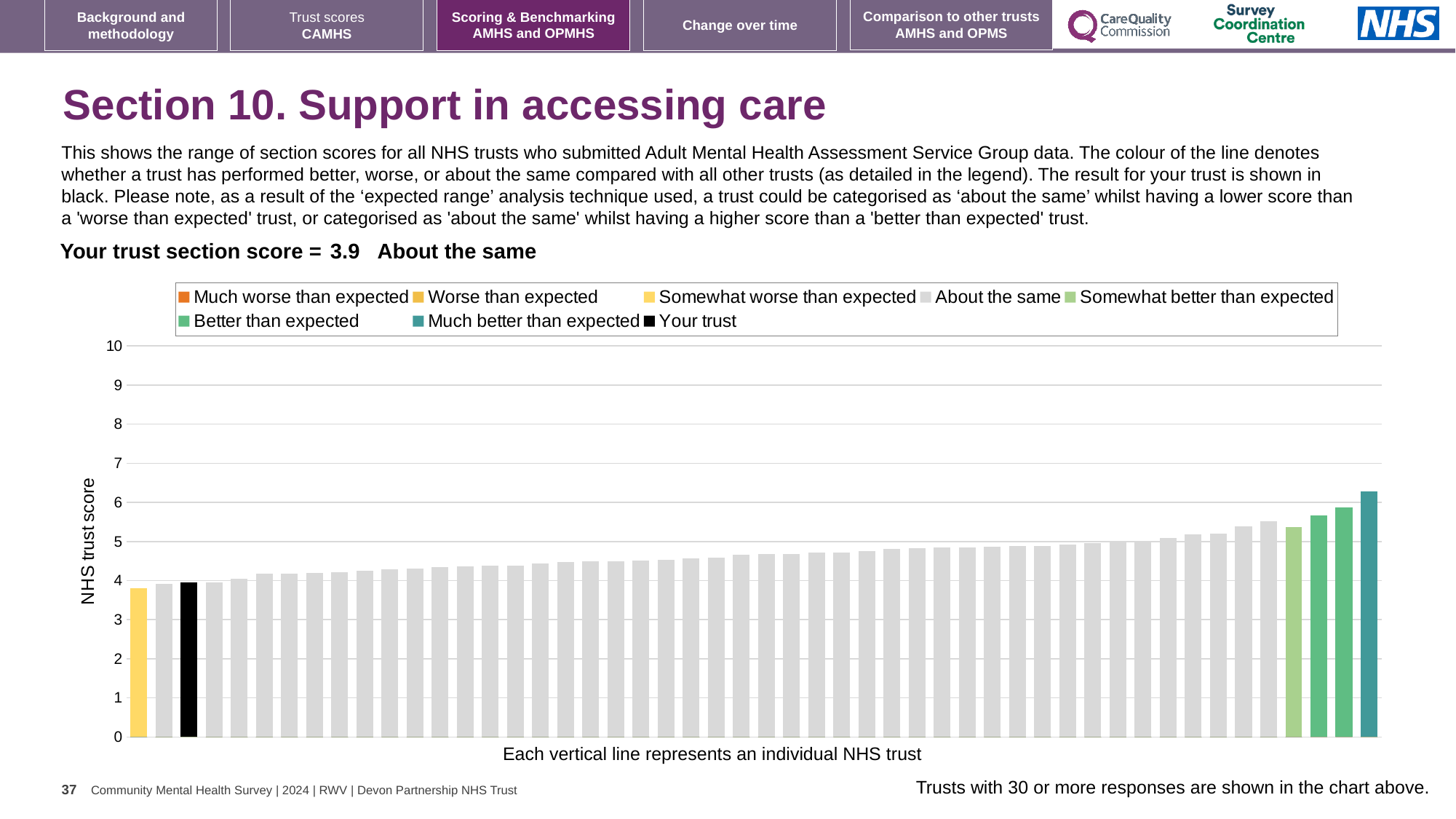
What is the section score for your trust? 3.9 How is your trust categorised compared with other trusts? About the same Do the bar values rise or fall from left to right along the x axis? rise Which legend category does the highest-scoring trust belong to? Much better than expected How many entries does the chart legend list? 8 Is the highest bar in the chart greater or less than 7? less What kind of chart is shown on the slide? bar chart Which legend category does the lowest-scoring trust belong to? Somewhat worse than expected Is the score for your trust (black bar) greater or less than 5? less What is the label on the vertical axis of the chart? NHS trust score Is the highest bar in the chart greater or less than 6? greater